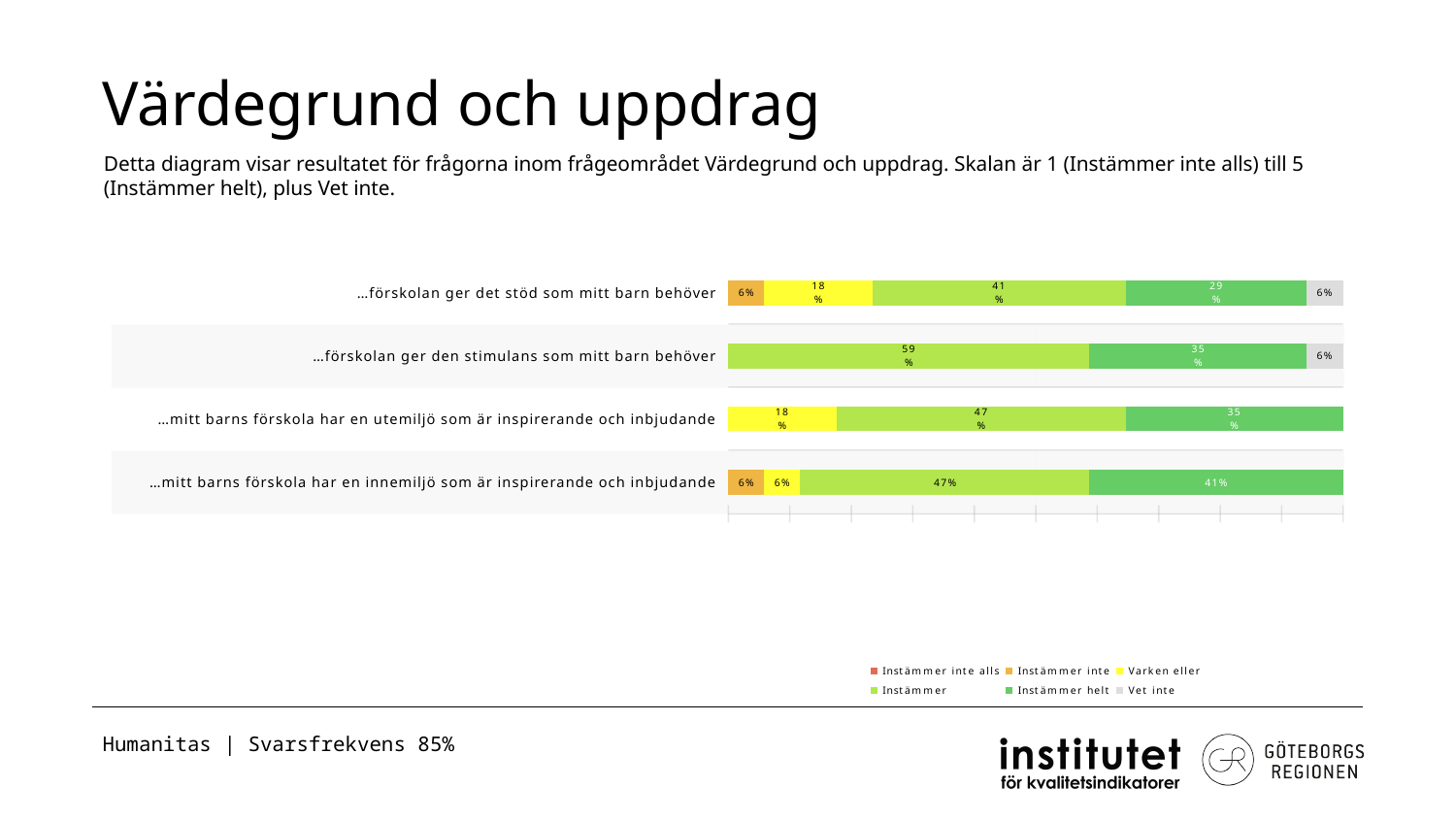
What is the 'Instämmer' share for '…förskolan ger den stimulans som mitt barn behöver'? 59% How many statements (categories) are shown in the chart? 4 Which statement has the highest 'Instämmer' share? …förskolan ger den stimulans som mitt barn behöver What is the title of the slide containing the chart? Värdegrund och uppdrag Which is larger: the 'Instämmer helt' share for '…förskolan ger den stimulans som mitt barn behöver' or for '…förskolan ger det stöd som mitt barn behöver'? …förskolan ger den stimulans som mitt barn behöver What is the 'Instämmer helt' share for '…mitt barns förskola har en innemiljö som är inspirerande och inbjudande'? 41% How many series does the legend list? 6 What is the 'Instämmer helt' share for '…förskolan ger det stöd som mitt barn behöver'? 29% Which statement has the highest 'Instämmer helt' share? …mitt barns förskola har en innemiljö som är inspirerande och inbjudande What kind of chart is shown on the slide? Stacked bar chart What is the 'Varken eller' share for '…mitt barns förskola har en utemiljö som är inspirerande och inbjudande'? 18% What is the difference between the 'Instämmer' share for '…förskolan ger den stimulans som mitt barn behöver' and for '…förskolan ger det stöd som mitt barn behöver'? 18%